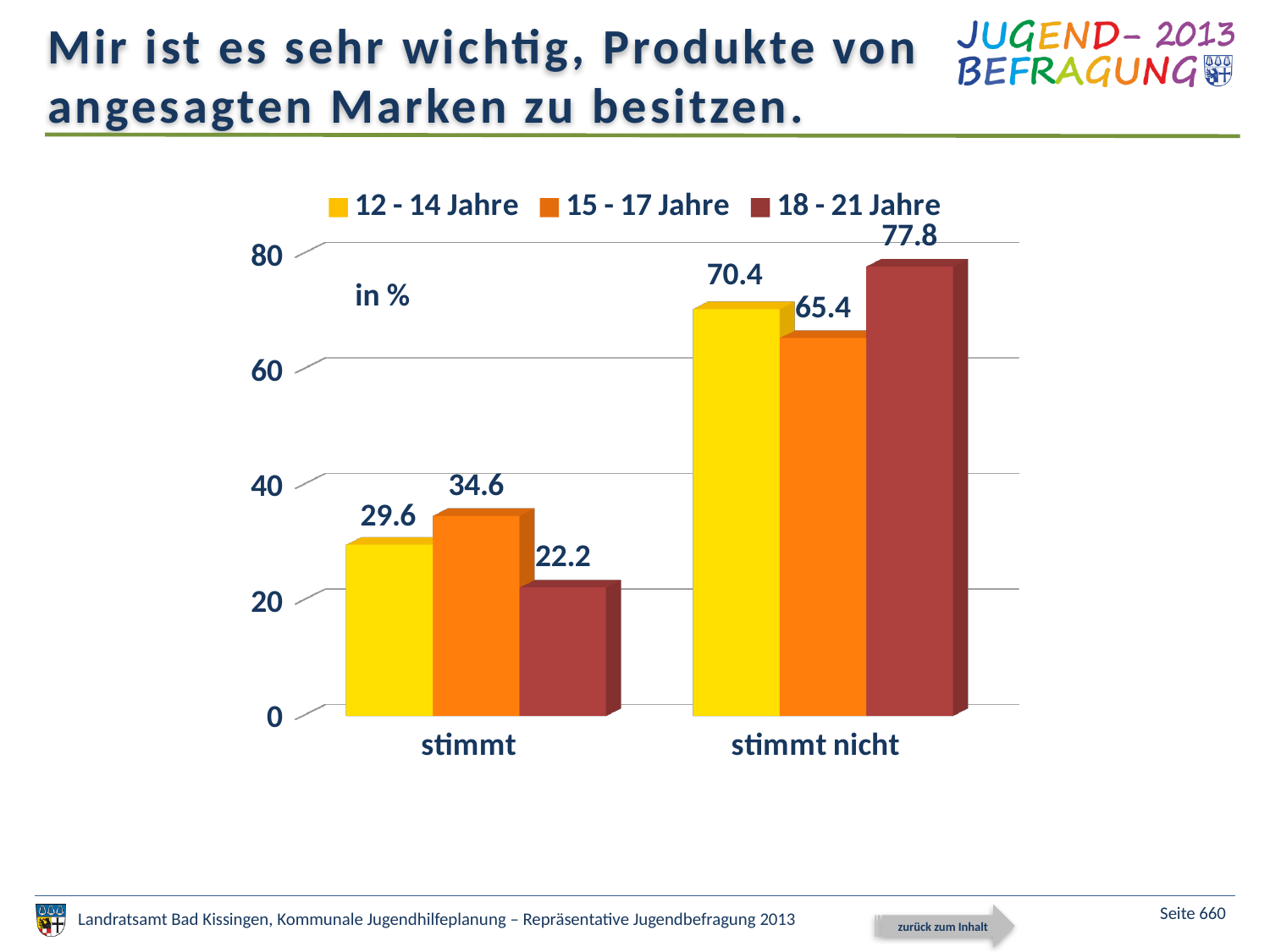
Which age group has the lowest value in the "stimmt" category? 18 - 21 Jahre What is the value for the 15 - 17 Jahre series in the "stimmt" category? 34.6 What unit is indicated for the values on the chart? % What kind of chart is shown on the slide? bar chart Which age group has the highest value in the "stimmt nicht" category? 18 - 21 Jahre What is the value for the 12 - 14 Jahre series in the "stimmt" category? 29.6 How many series does the legend list? 3 How many categories are shown on the x axis? 2 Is the value for 18 - 21 Jahre in the "stimmt" category greater or less than 40? less Which is larger in the "stimmt" category: the value for 12 - 14 Jahre or for 15 - 17 Jahre? 15 - 17 Jahre What is the value for the 18 - 21 Jahre series in the "stimmt nicht" category? 77.8 What is the difference between the 12 - 14 Jahre and 15 - 17 Jahre values in the "stimmt nicht" category? 5